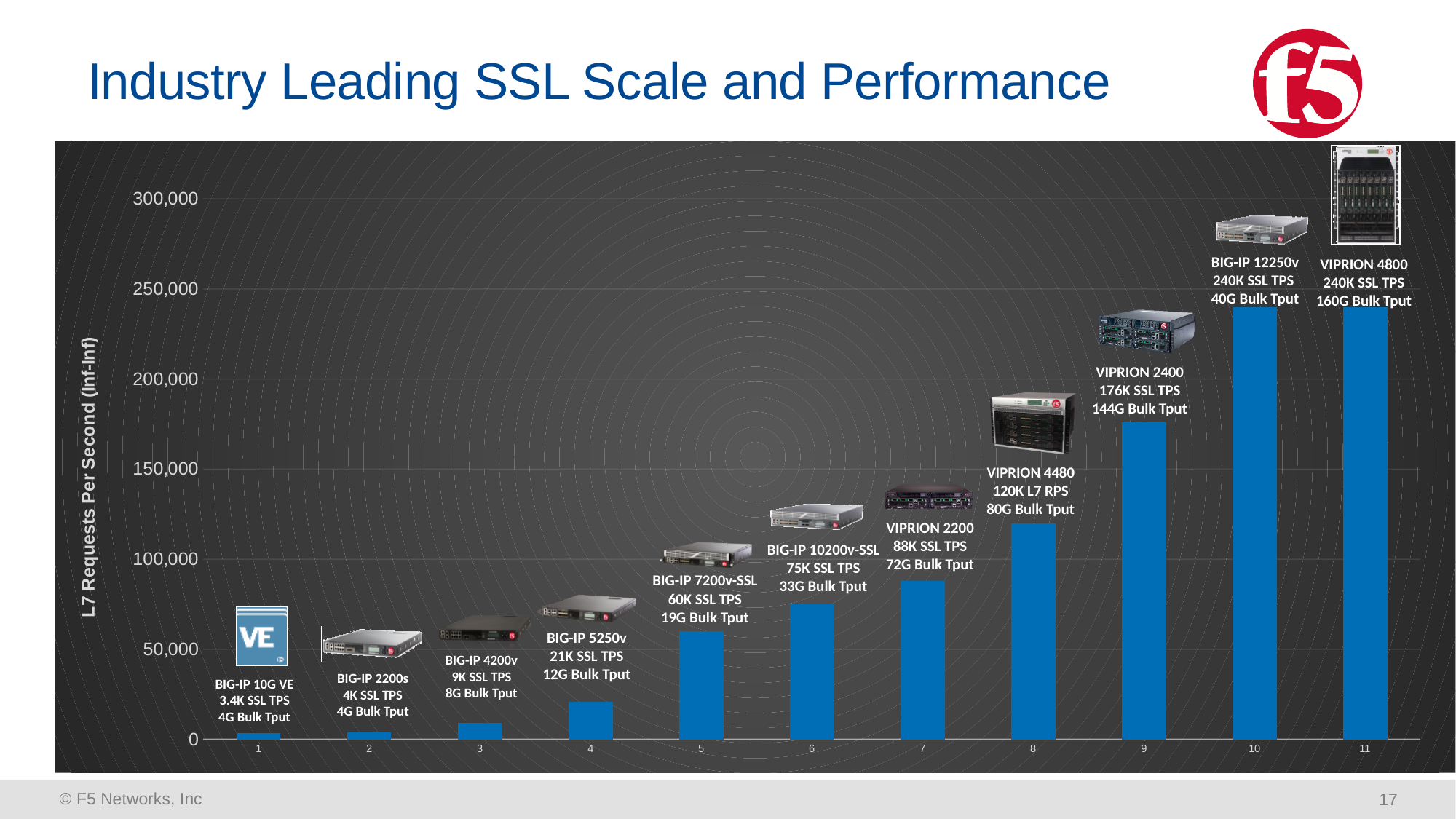
What is the highest tick value shown on the y-axis? 300,000 What kind of chart is shown on the slide? bar chart Do the bar values generally rise or fall from category 1 to category 11? rise Which has the larger value, category 3 or category 5? category 5 How many bars are plotted in the chart? 11 Is the value for category 4 greater or less than 50,000? less Is the value for category 9 greater or less than 200,000? less Is the value for category 10 greater or less than 200,000? greater Which has the larger value, category 9 or category 8? category 9 What is the y-axis title of the chart? L7 Requests Per Second (Inf-Inf)